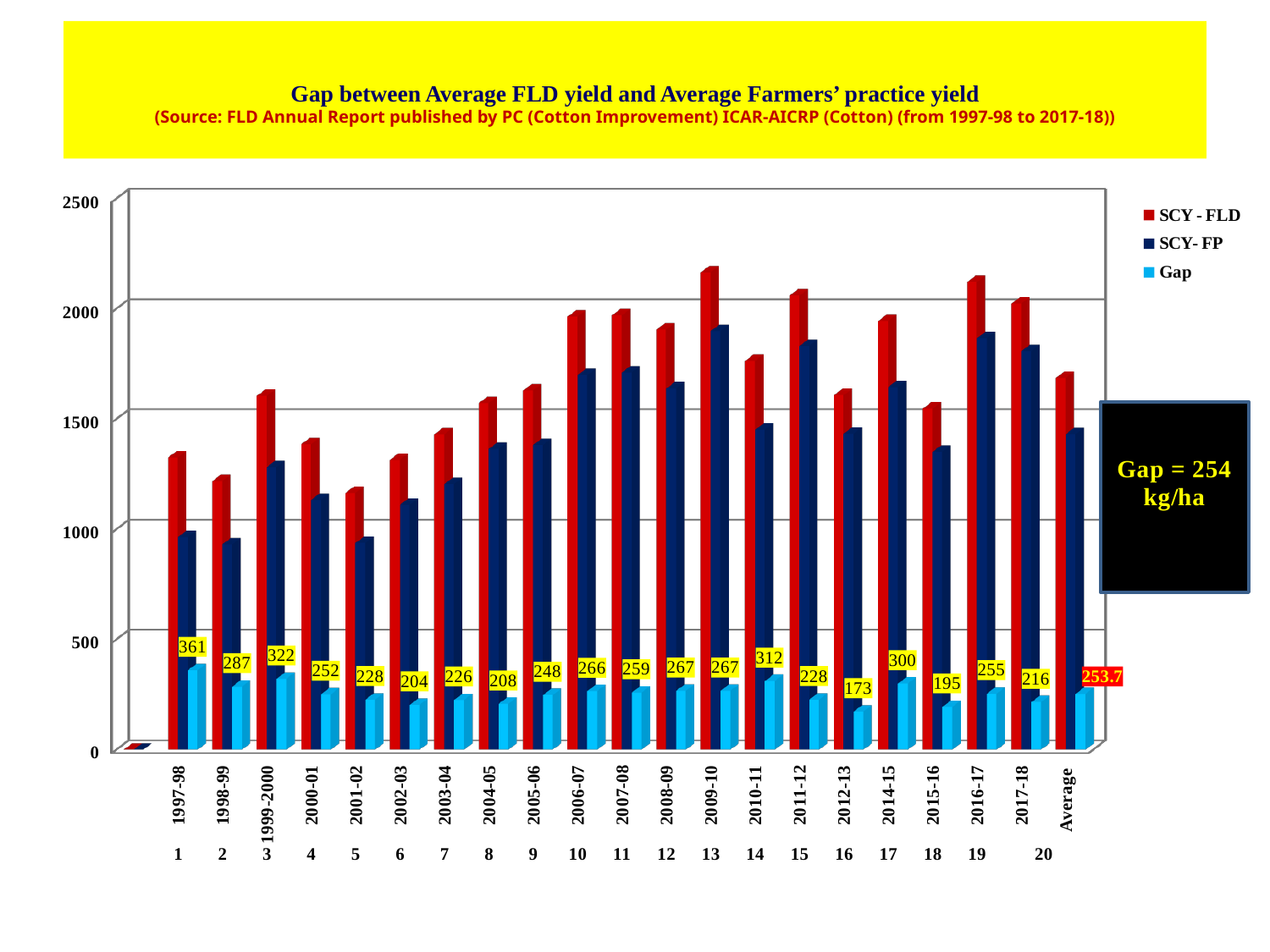
Which year has the lowest Gap value? 2012-13 How many series does the legend list? 3 Which year has the larger Gap value, 2010-11 or 2011-12? 2010-11 What is the Gap value shown for the Average category? 253.7 Which year has the highest Gap value? 1997-98 Is the SCY - FLD value for 2001-02 greater or less than 1500? less Which colour represents the Gap series in the legend? Light blue What is the Gap value for 2012-13? 173 What kind of chart is shown on the slide? Bar chart What is the Gap value for 1997-98? 361 Is the SCY - FLD value for 2009-10 greater or less than 2000? greater What is the difference between the Gap values for 1997-98 and 2012-13? 188